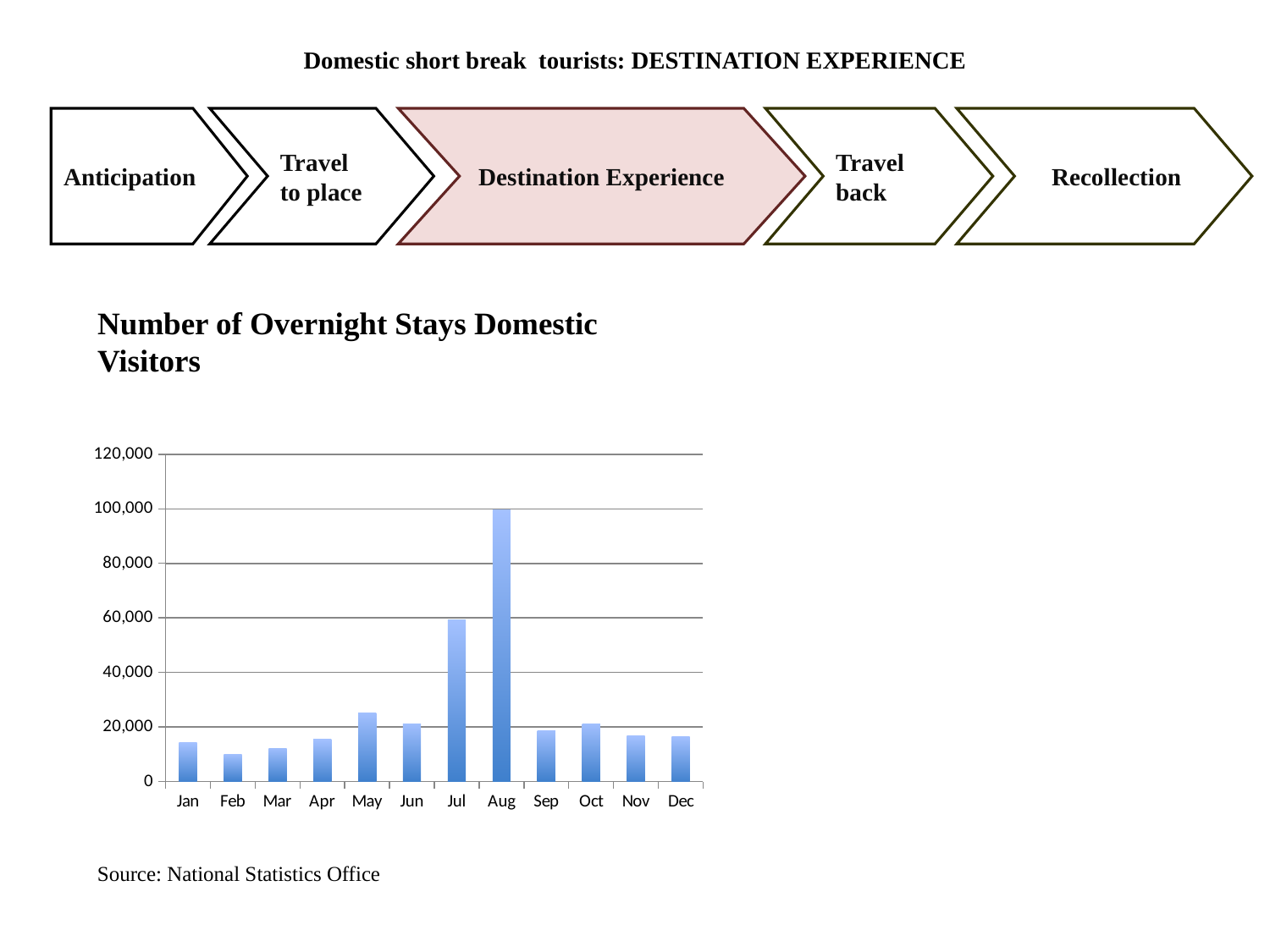
Is the value for Jul greater or less than 40,000? greater Do the values rise or fall from Jun to Aug? rise Which month has more overnight stays, Jul or May? Jul Which month has the highest number of overnight stays? Aug Is the value for Feb greater or less than 20,000? less Which month has the lowest number of overnight stays? Feb What source is cited below the chart? National Statistics Office What kind of chart is shown on the slide? Bar chart Is the value for May greater or less than 20,000? greater How many months are plotted on the x axis of the chart? 12 What is the title of the chart? Number of Overnight Stays Domestic Visitors